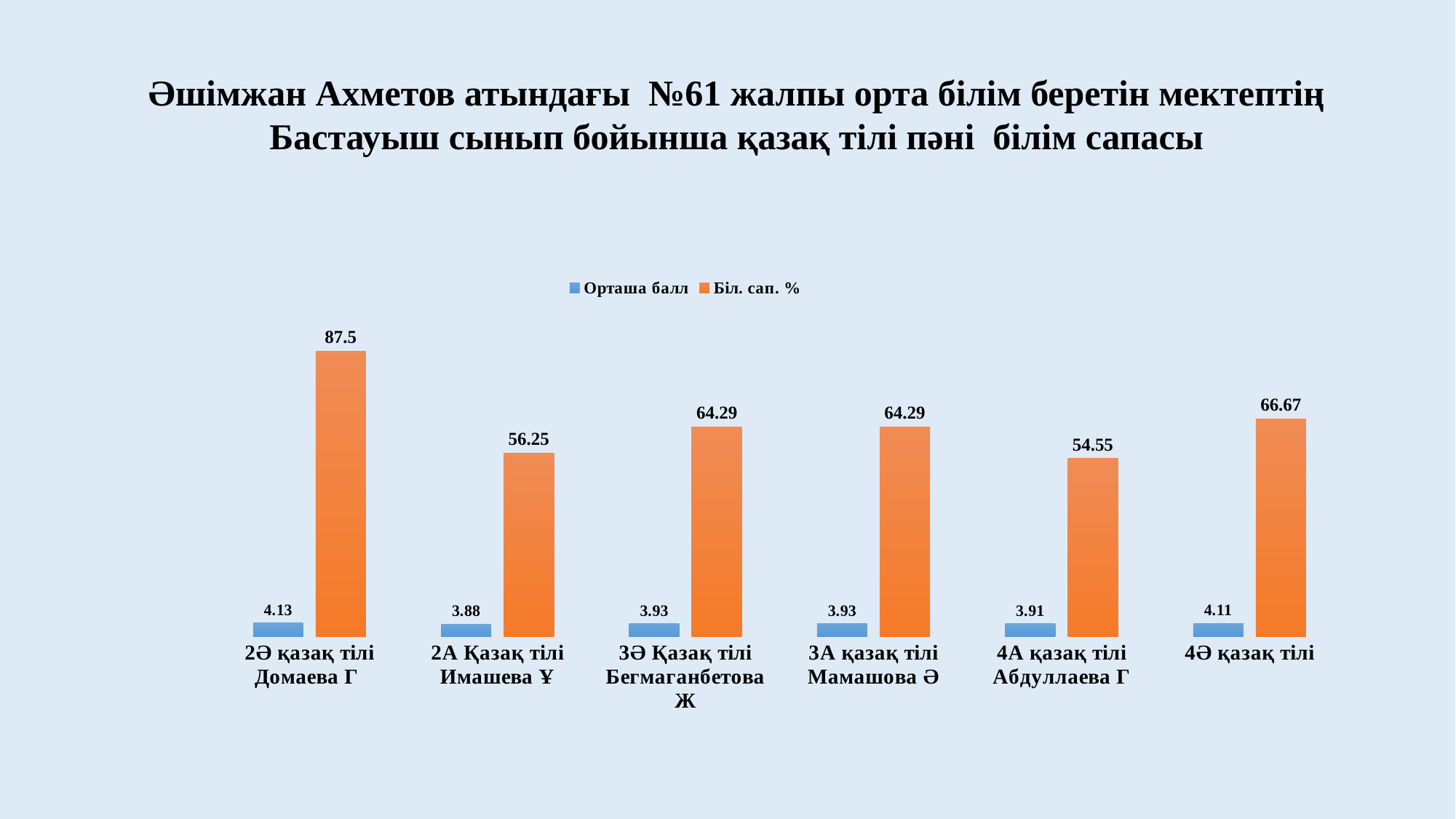
What is the Орташа балл value for 4А қазақ тілі Абдуллаева Г? 3.91 What kind of chart is shown on the slide? Bar chart What is the difference between the Біл. сап. % values for 2Ә қазақ тілі Домаева Г and 2А Қазақ тілі Имашева Ұ? 31.25 How many categories are shown on the chart? 6 What is the Біл. сап. % value for 2Ә қазақ тілі Домаева Г? 87.5 How many series does the legend list? 2 Which has a larger Біл. сап. % value: 4Ә қазақ тілі or 3А қазақ тілі Мамашова Ә? 4Ә қазақ тілі Which category has the highest Біл. сап. % value? 2Ә қазақ тілі Домаева Г What is the Біл. сап. % value for 4Ә қазақ тілі? 66.67 Which category has the lowest Біл. сап. % value? 4А қазақ тілі Абдуллаева Г What is the Орташа балл value for 2А Қазақ тілі Имашева Ұ? 3.88 Which category has the lowest Орташа балл value? 2А Қазақ тілі Имашева Ұ